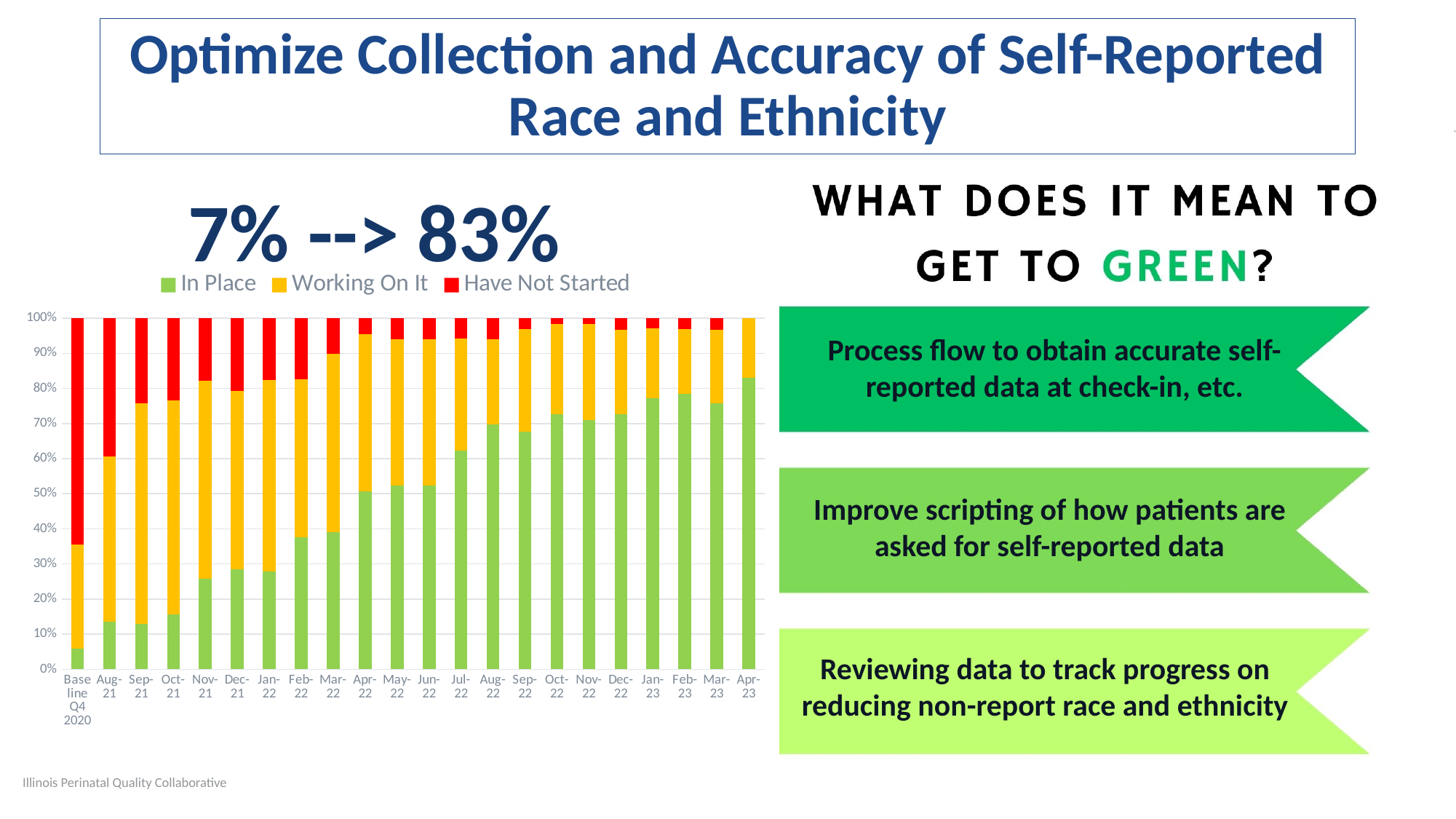
How many time periods (categories) are shown along the x axis of the chart? 22 Does the In Place share generally rise or fall from Baseline Q4 2020 to Apr-23? rise What kind of chart is shown on the slide? Stacked bar chart Is the In Place value for Nov-21 greater or less than 30%? less How many series does the chart legend list? 3 Which category has the lowest In Place value? Baseline Q4 2020 Is the In Place value for Apr-23 greater or less than 80%? greater Which series in the chart is shown in red? Have Not Started What is the first category on the x axis of the chart? Baseline Q4 2020 Which category has the highest In Place value? Apr-23 Is the In Place value for Baseline Q4 2020 greater or less than 10%? less